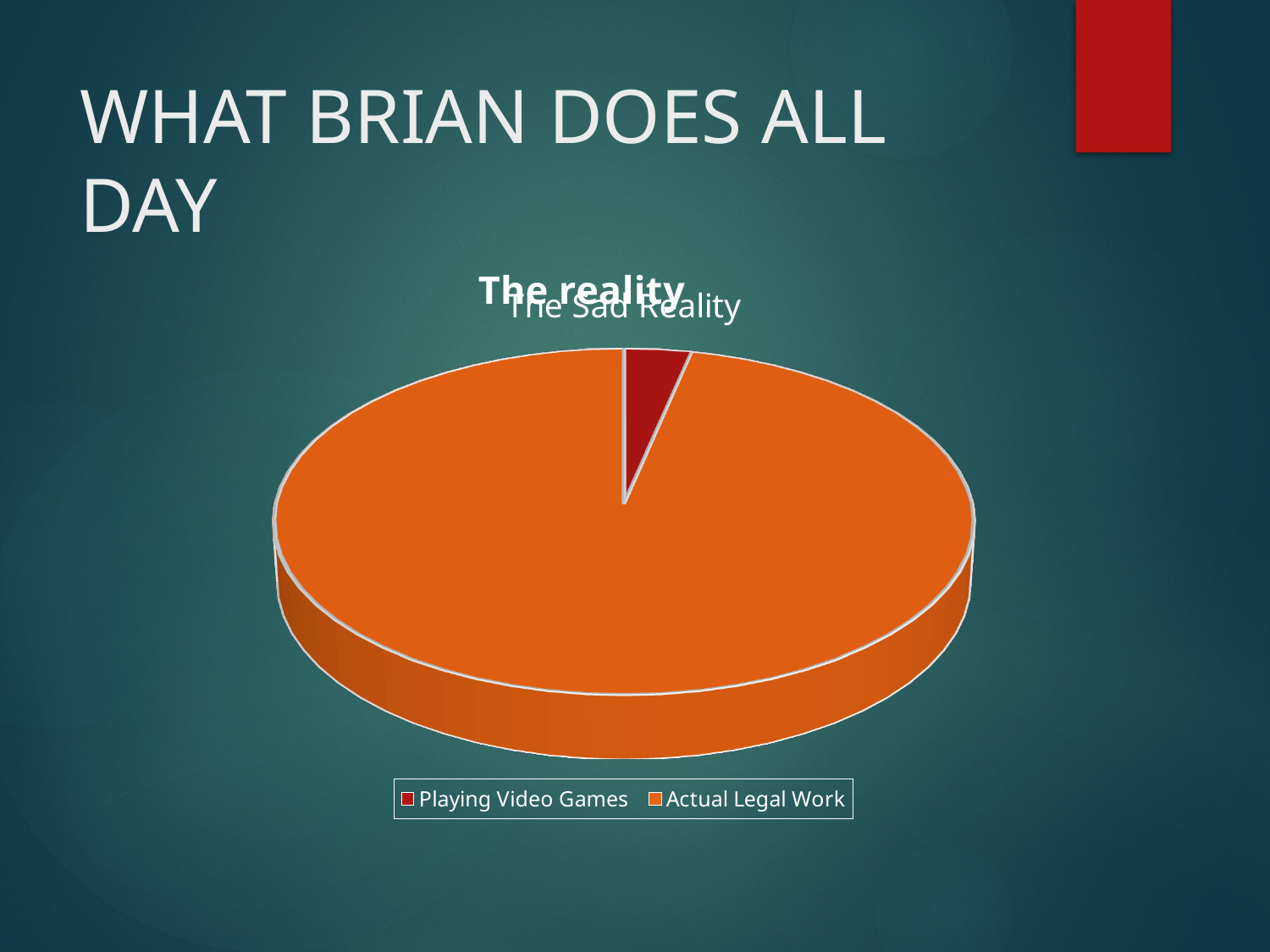
Which category has the smallest slice of the pie chart? Playing Video Games What kind of chart is shown on the slide? pie chart What colour is the Actual Legal Work slice in the pie chart? orange How many entries does the legend of the pie chart list? 2 How many slices does the pie chart have? 2 Which slice is larger, Playing Video Games or Actual Legal Work? Actual Legal Work Which category has the largest slice of the pie chart? Actual Legal Work What colour is the Playing Video Games slice in the pie chart? dark red